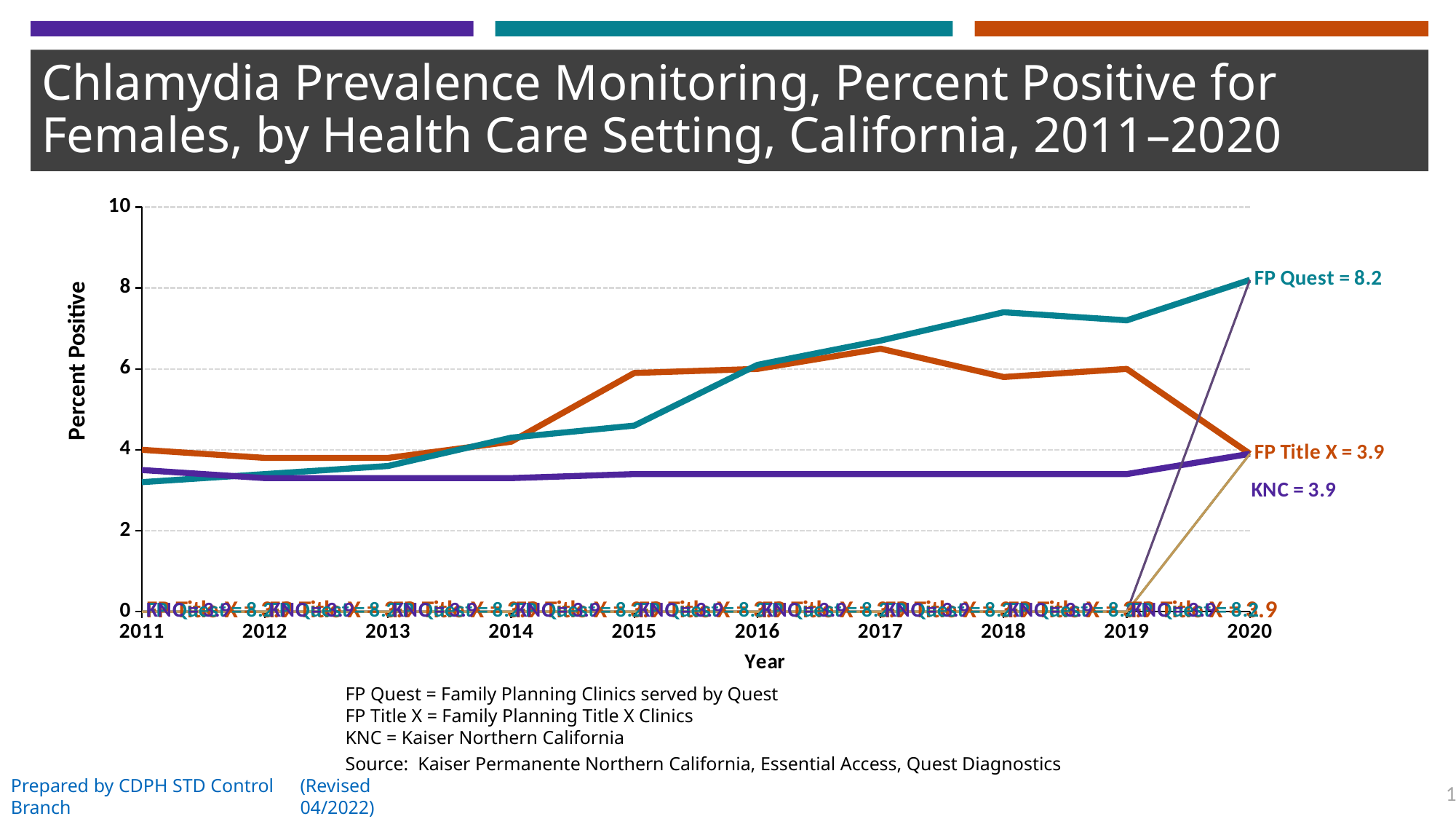
Which health care setting has the highest percent positive in 2020? FP Quest What is the label on the y axis of the chart? Percent Positive What is the percent positive for FP Title X in 2020? 3.9 How many years are plotted along the x axis? 10 What is the percent positive for KNC in 2020? 3.9 What kind of chart is shown on the slide? line chart In 2015, which is larger: the FP Title X value or the FP Quest value? FP Title X Is the value for KNC in 2015 greater or less than 4? less What is the percent positive for FP Quest in 2020? 8.2 In 2020, how much higher is the FP Quest value than the FP Title X value? 4.3 Is the value for FP Quest in 2018 greater or less than 6? greater How many series (lines) are plotted on the chart? 3